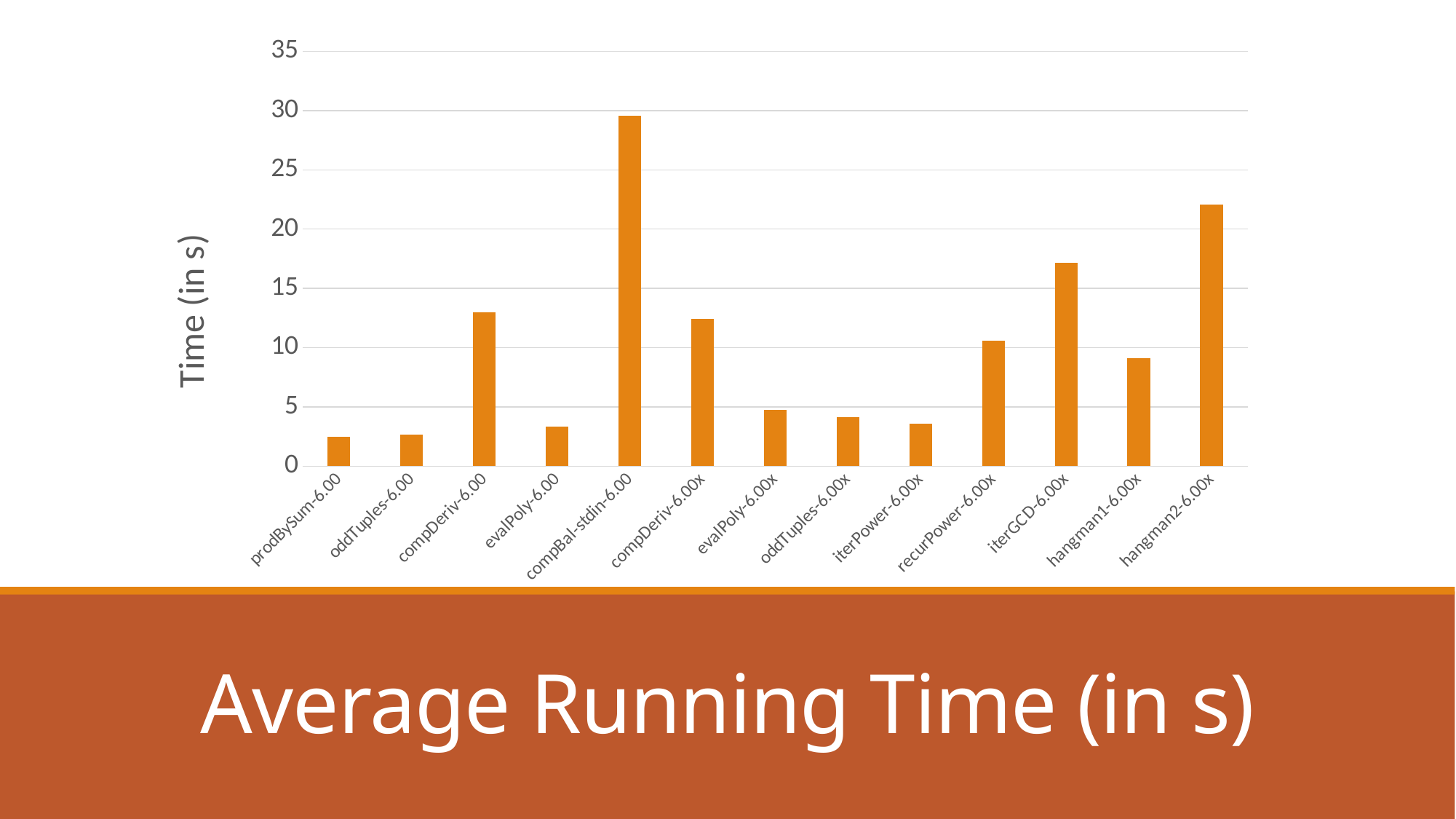
Is the value for compBal-stdin-6.00 greater or less than 25? greater Is the value for compDeriv-6.00x greater or less than 10? greater Is the value for evalPoly-6.00 greater or less than 5? less What is the label on the vertical axis of the chart? Time (in s) Which has a larger value, hangman1-6.00x or hangman2-6.00x? hangman2-6.00x Which has a larger value, hangman2-6.00x or iterGCD-6.00x? hangman2-6.00x What kind of chart is shown on the slide? bar chart Which category has the highest average running time? compBal-stdin-6.00 How many categories (bars) are plotted in the chart? 13